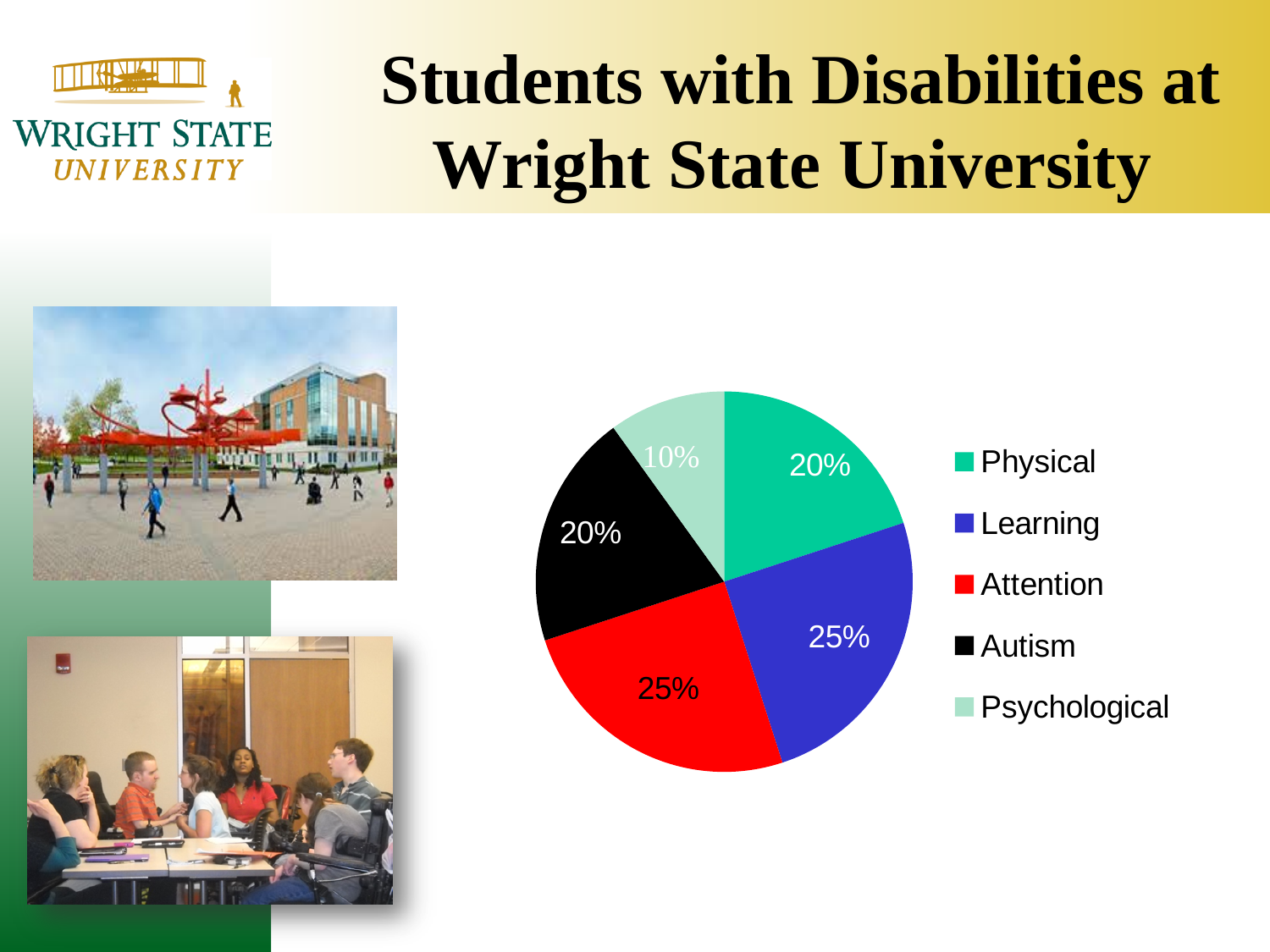
Which is larger, the Attention share or the Autism share? Attention How many categories does the pie chart show? 5 What kind of chart is shown on the slide? pie chart What share of the pie is Psychological? 10% What colour is the Autism slice in the pie chart? black What share of the pie is Physical? 20% What share of the pie is Learning? 25% What share of the pie is Autism? 20% What share of the pie is Attention? 25% Which category has the smallest slice of the pie? Psychological What is the difference between the Learning share and the Psychological share? 15% How many entries does the legend list? 5